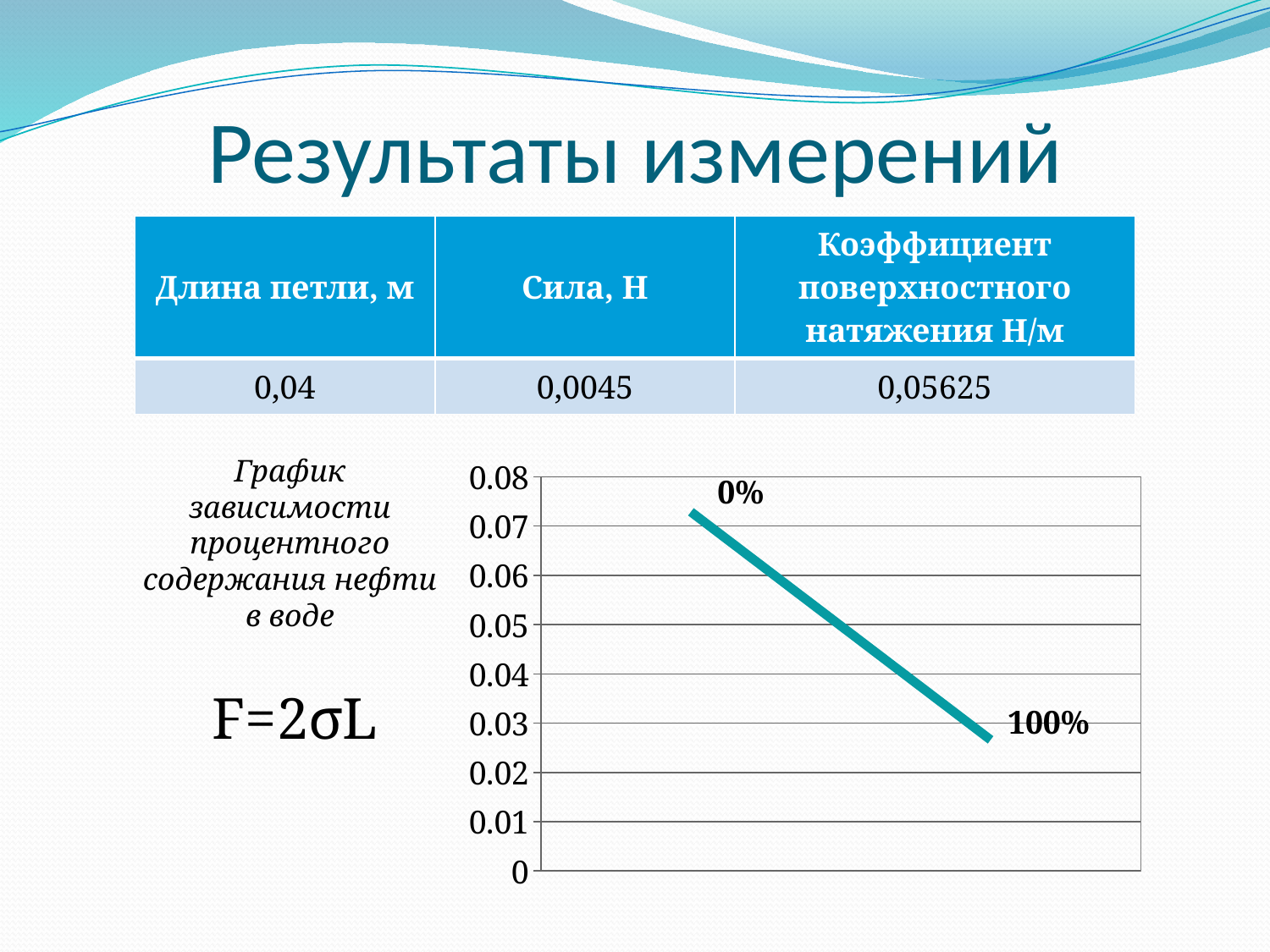
What colour is the line plotted on the chart? teal Is the value at the 100% point greater or less than 0.04? less Which labelled point on the line chart has the highest value? 0% Which labelled point on the line chart has the lowest value? 100% Which point on the line chart has the higher value, 0% or 100%? 0% How many data points are plotted on the line chart? 2 Do the values on the line chart rise or fall from 0% to 100%? fall What is the highest tick value shown on the vertical axis of the chart? 0.08 Is the value at the 100% point greater or less than 0.02? greater What kind of chart is shown on the slide? line chart Is the value at the 0% point greater or less than 0.06? greater